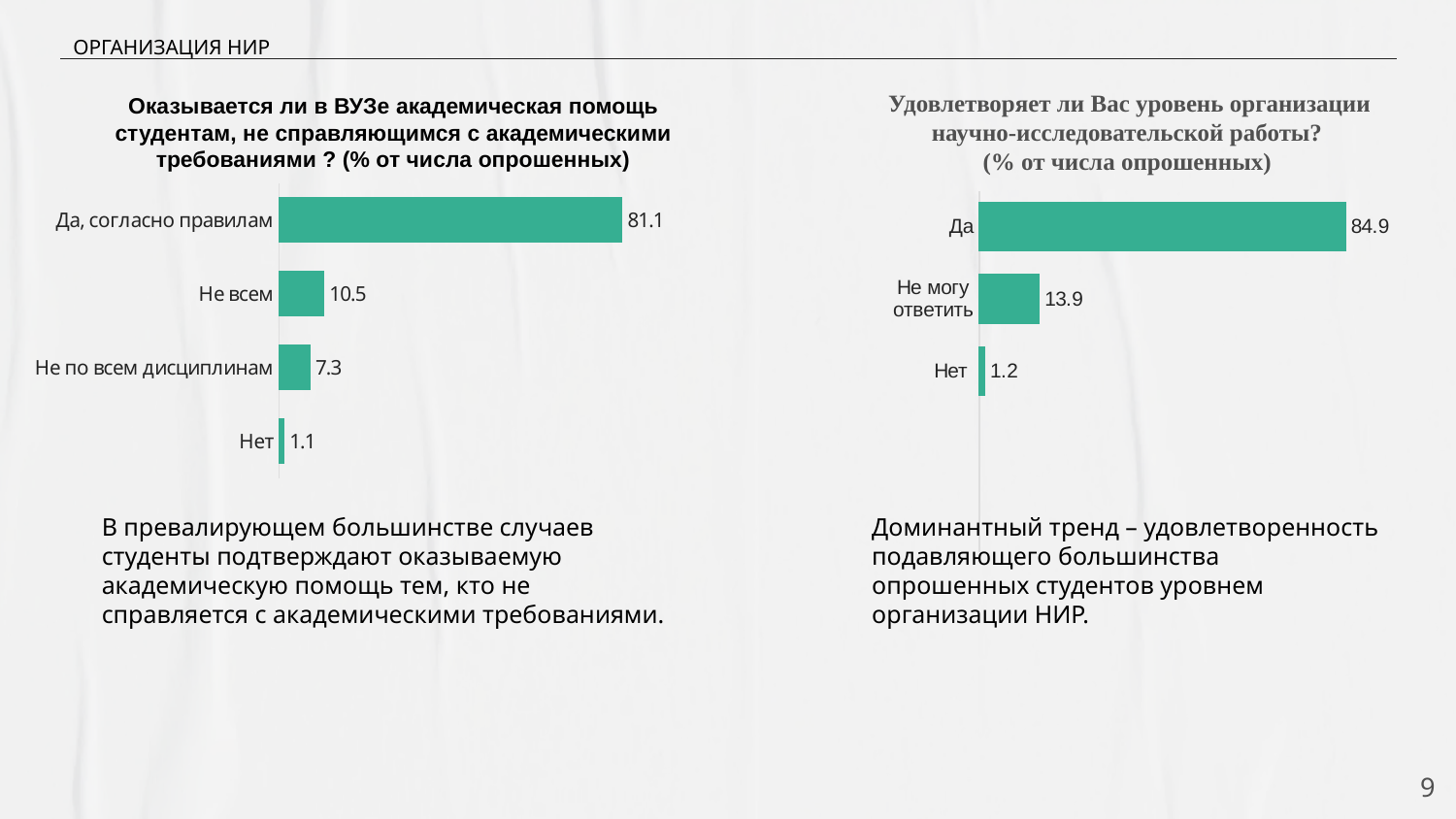
In the right chart (satisfaction with research work organisation), how many categories are shown? 3 In the left chart (academic help to students), what is the value for 'Да, согласно правилам'? 81.1 In the right chart (satisfaction with research work organisation), what is the value for 'Да'? 84.9 In the right chart (satisfaction with research work organisation), what is the difference between 'Да' and 'Нет'? 83.7 In the left chart (academic help to students), what is the value for 'Не по всем дисциплинам'? 7.3 In the left chart (academic help to students), how many categories are shown? 4 In the right chart (satisfaction with research work organisation), which category has the highest value? Да In the right chart (satisfaction with research work organisation), what is the value for 'Не могу ответить'? 13.9 Which is larger: 'Нет' in the left chart or 'Нет' in the right chart? 'Нет' in the right chart (1.2) What type of chart is the left chart (academic help to students)? Bar chart In the left chart (academic help to students), which category has the lowest value? Нет In the left chart (academic help to students), what is the difference between 'Не всем' and 'Не по всем дисциплинам'? 3.2